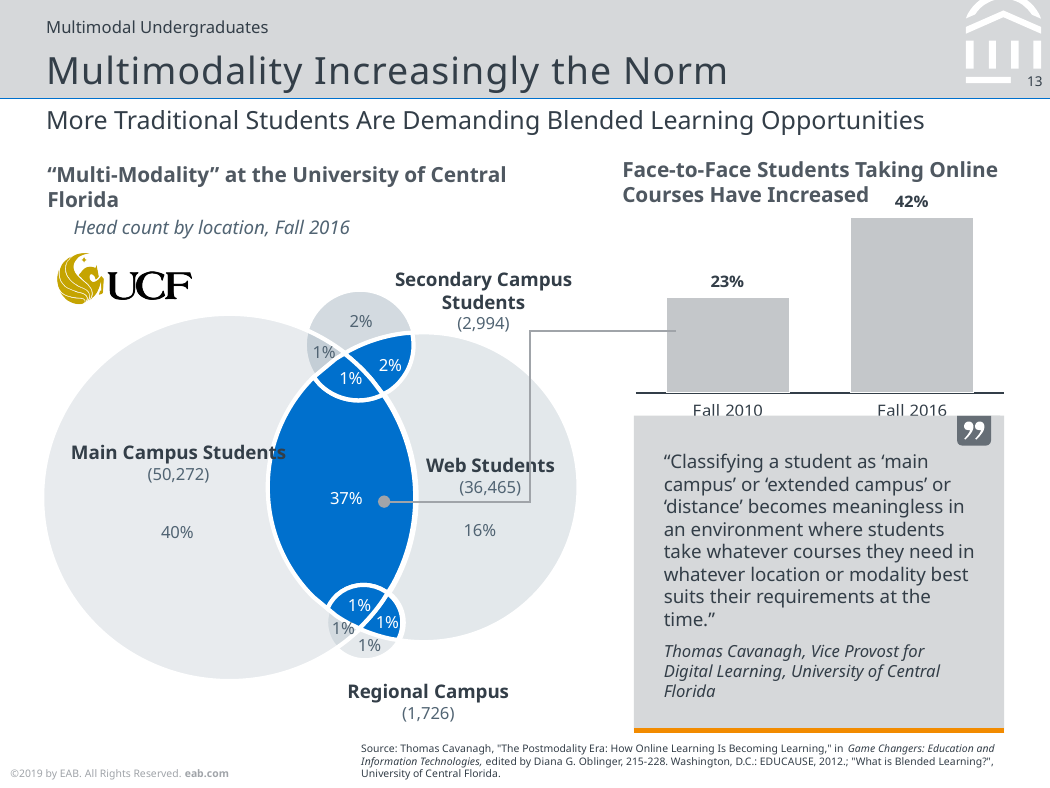
In the Venn diagram on the left, which group has the larger head count, Secondary Campus Students or Regional Campus? Secondary Campus Students In the chart titled "Face-to-Face Students Taking Online Courses Have Increased", which period has the higher value? Fall 2016 In the chart titled "Face-to-Face Students Taking Online Courses Have Increased", which period has the lower value? Fall 2010 In the chart titled "Face-to-Face Students Taking Online Courses Have Increased", do the values rise or fall from Fall 2010 to Fall 2016? Rise In the chart titled "Face-to-Face Students Taking Online Courses Have Increased", what is the value for Fall 2016? 42% In the Venn diagram on the left, what is the head count for Main Campus Students? 50,272 What kind of chart is "Face-to-Face Students Taking Online Courses Have Increased"? Bar chart In the Venn diagram on the left, what is the head count for Web Students? 36,465 In the chart titled "Face-to-Face Students Taking Online Courses Have Increased", how many bars are shown? 2 In the Venn diagram on the left, what percentage is shown in the overlap between Main Campus Students and Web Students? 37% In the chart titled "Face-to-Face Students Taking Online Courses Have Increased", by how many percentage points does Fall 2016 exceed Fall 2010? 19 percentage points In the chart titled "Face-to-Face Students Taking Online Courses Have Increased", what is the value for Fall 2010? 23%